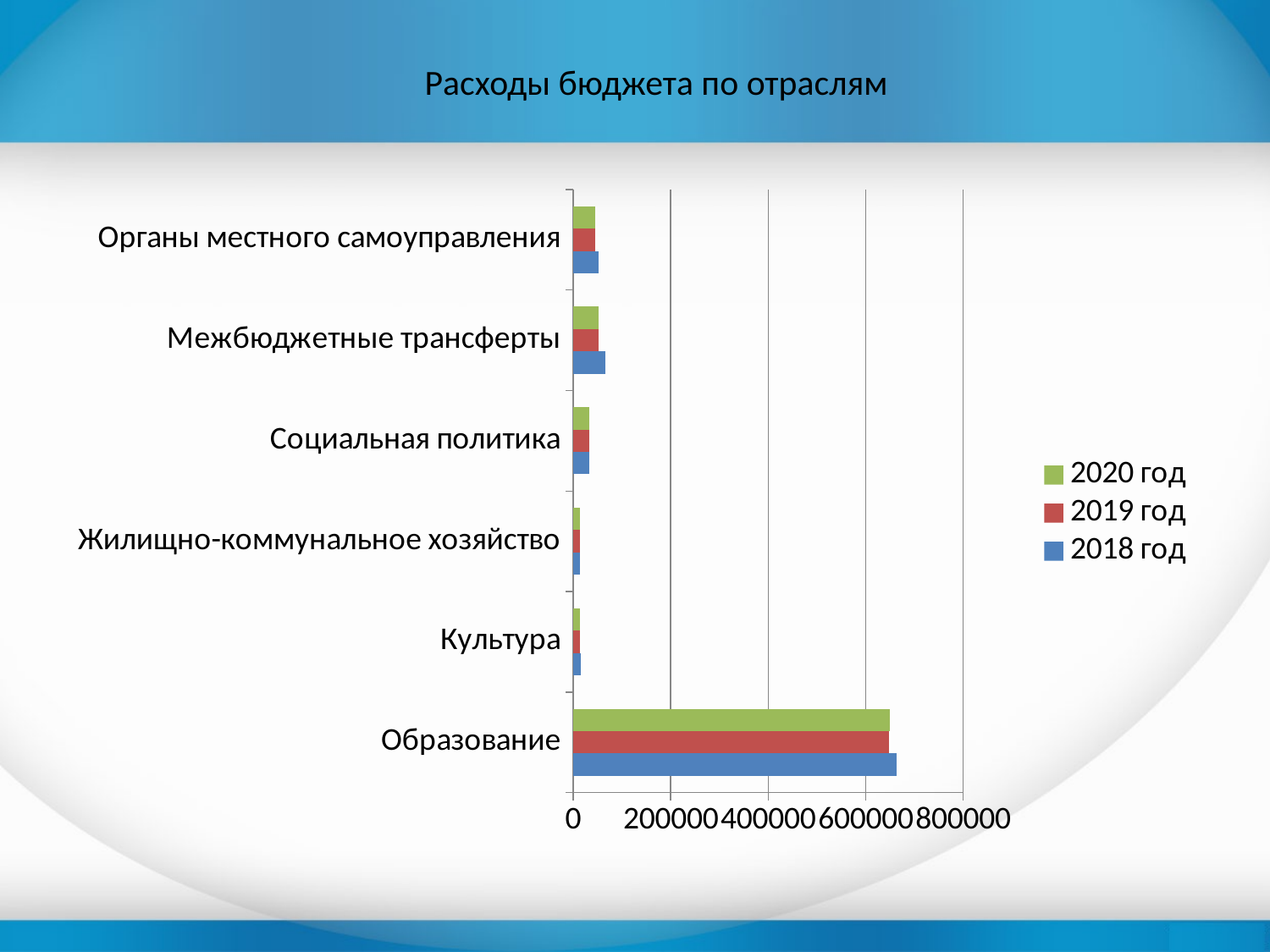
Which is larger for 2020 год: Образование or Социальная политика? Образование Is the value for Межбюджетные трансферты in 2018 год greater or less than 200000? less Which category has the highest value for 2020 год? Образование Which series is shown in green in the legend? 2020 год Is the value for Культура in 2020 год greater or less than 200000? less Which is larger for 2019 год: Образование or Органы местного самоуправления? Образование How many categories are shown on the chart? 6 What kind of chart is shown on the slide? bar chart How many series does the legend list? 3 Which category has the highest value for 2018 год? Образование Is the value for Образование in 2018 год greater or less than 600000? greater What is the title of the chart? Расходы бюджета по отраслям